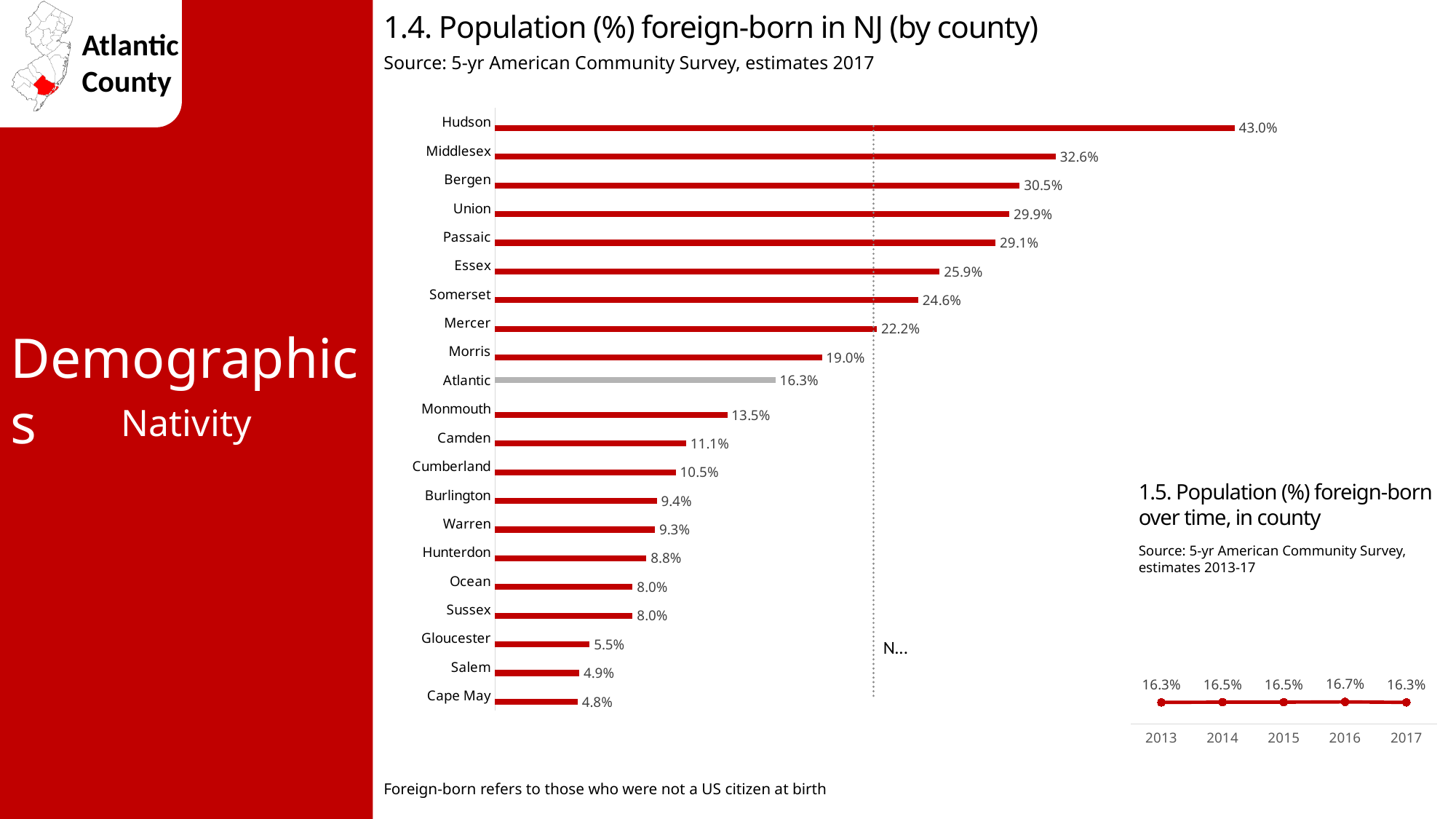
In the chart '1.5. Population (%) foreign-born over time, in county', how many years are plotted? 5 In the chart '1.4. Population (%) foreign-born in NJ (by county)', what is the value for Hudson? 43.0% In the chart '1.4. Population (%) foreign-born in NJ (by county)', which county has the highest value? Hudson In the chart '1.4. Population (%) foreign-born in NJ (by county)', what is the value for Atlantic? 16.3% In the chart '1.4. Population (%) foreign-born in NJ (by county)', how many counties are shown? 21 In the chart '1.5. Population (%) foreign-born over time, in county', what is the value for 2016? 16.7% In the chart '1.5. Population (%) foreign-born over time, in county', which year has the highest value? 2016 In the chart '1.4. Population (%) foreign-born in NJ (by county)', which county has the lowest value? Cape May What kind of chart is '1.4. Population (%) foreign-born in NJ (by county)'? Bar chart In the chart '1.4. Population (%) foreign-born in NJ (by county)', which bar is shown in grey instead of red? Atlantic In the chart '1.4. Population (%) foreign-born in NJ (by county)', what is the difference between Middlesex and Bergen? 2.1% In the chart '1.4. Population (%) foreign-born in NJ (by county)', which is larger, Camden or Cumberland? Camden